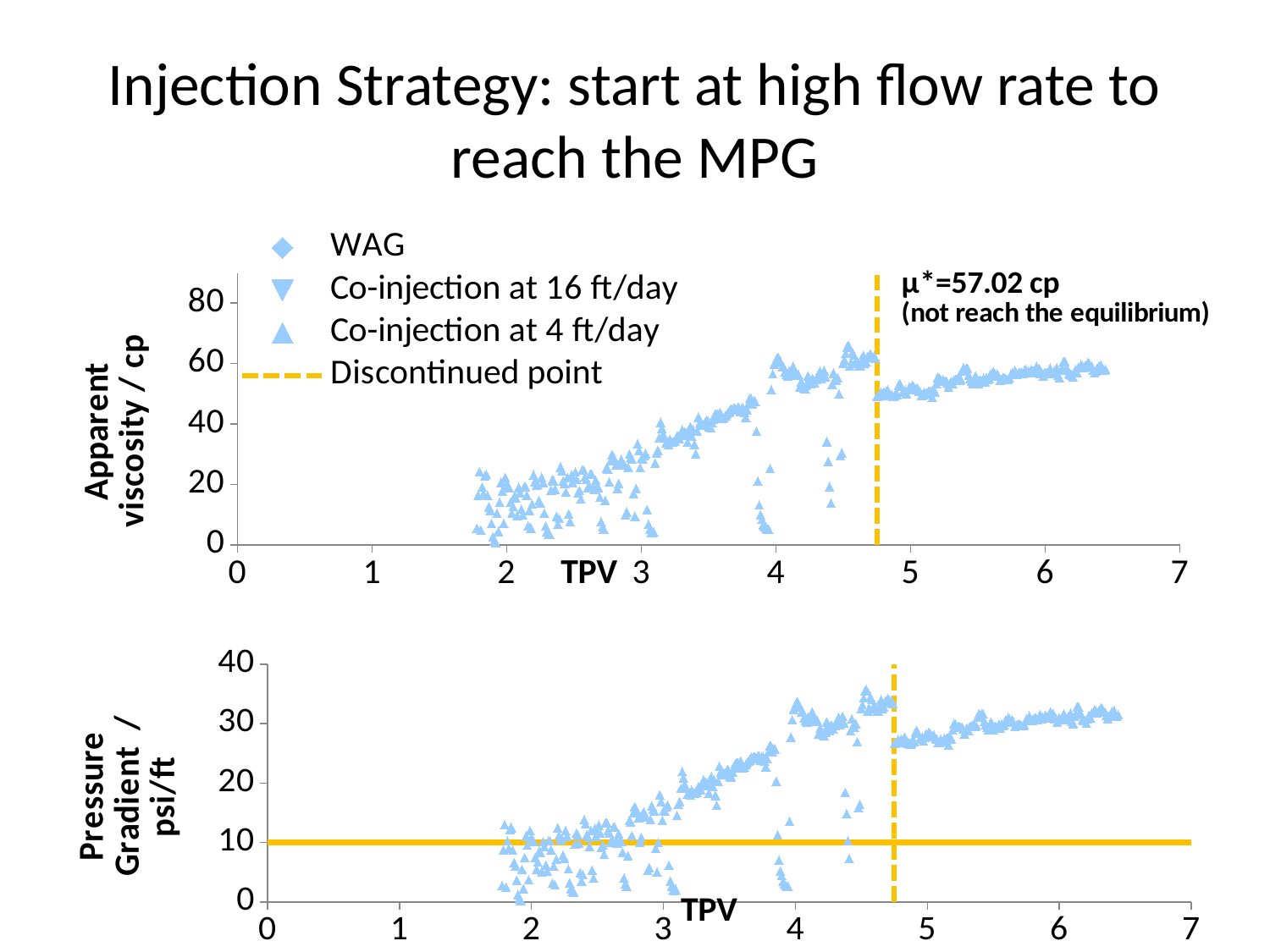
In the bottom chart, what is the maximum value shown on the y axis? 40 In the top chart, what value of μ* is stated in the annotation next to the dashed line? 57.02 cp In the bottom chart, are the pressure gradient values at TPV 6 greater or less than 20? greater In the top chart, what is the label of the y axis? Apparent viscosity / cp What kind of chart is the top chart on the slide? scatter chart In the top chart, do the apparent viscosity values generally rise or fall as TPV increases from 2 to 4? rise In the bottom chart, are the pressure gradient values at TPV 2 greater or less than 20? less In the top chart, are the apparent viscosity values at TPV 6 greater or less than 40? greater In the bottom chart, do the pressure gradient values generally rise or fall as TPV increases from 3 to 4? rise How many entries does the legend on the top chart list? 4